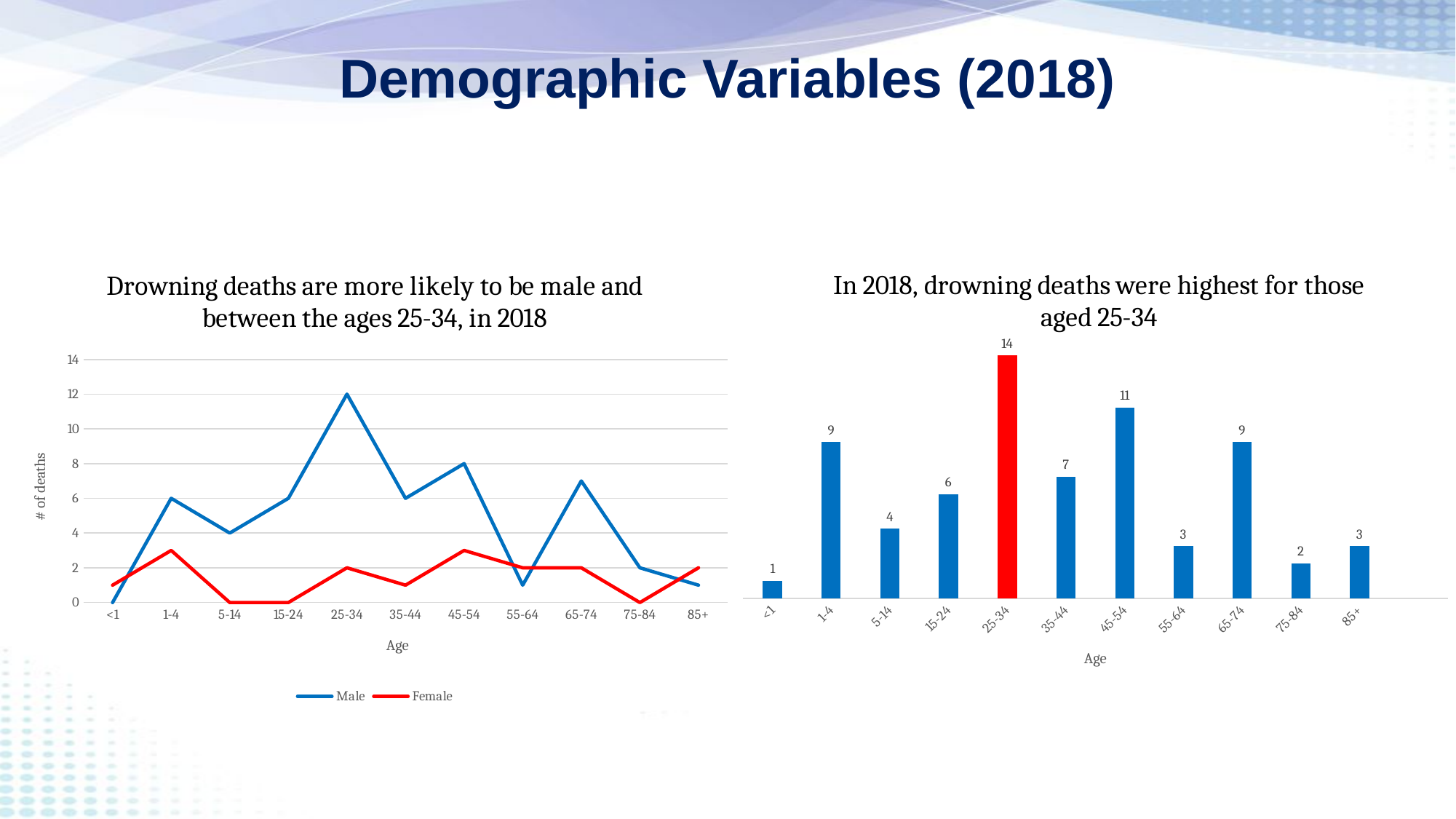
In the chart on the left, what is the number of Male drowning deaths for the 25-34 age group? 12 In the chart on the right, what is the difference in drowning deaths between the 25-34 and 45-54 age groups? 3 In the chart on the right, which has more drowning deaths, the 35-44 age group or the 65-74 age group? 65-74 What kind of chart is the chart on the right of the slide? bar chart In the chart on the left, which series is drawn in red? Female In the chart on the right, which age group has the lowest number of drowning deaths? <1 In the chart on the right, how many drowning deaths were there for those aged 25-34? 14 In the chart on the left, how many series does the legend list? 2 In the chart on the right, how many age groups are shown on the x axis? 11 In the chart on the left, is the Male value for the 65-74 age group greater or less than 6? greater In the chart on the right, how many drowning deaths were there for those aged 45-54? 11 What kind of chart is the chart on the left of the slide? line chart